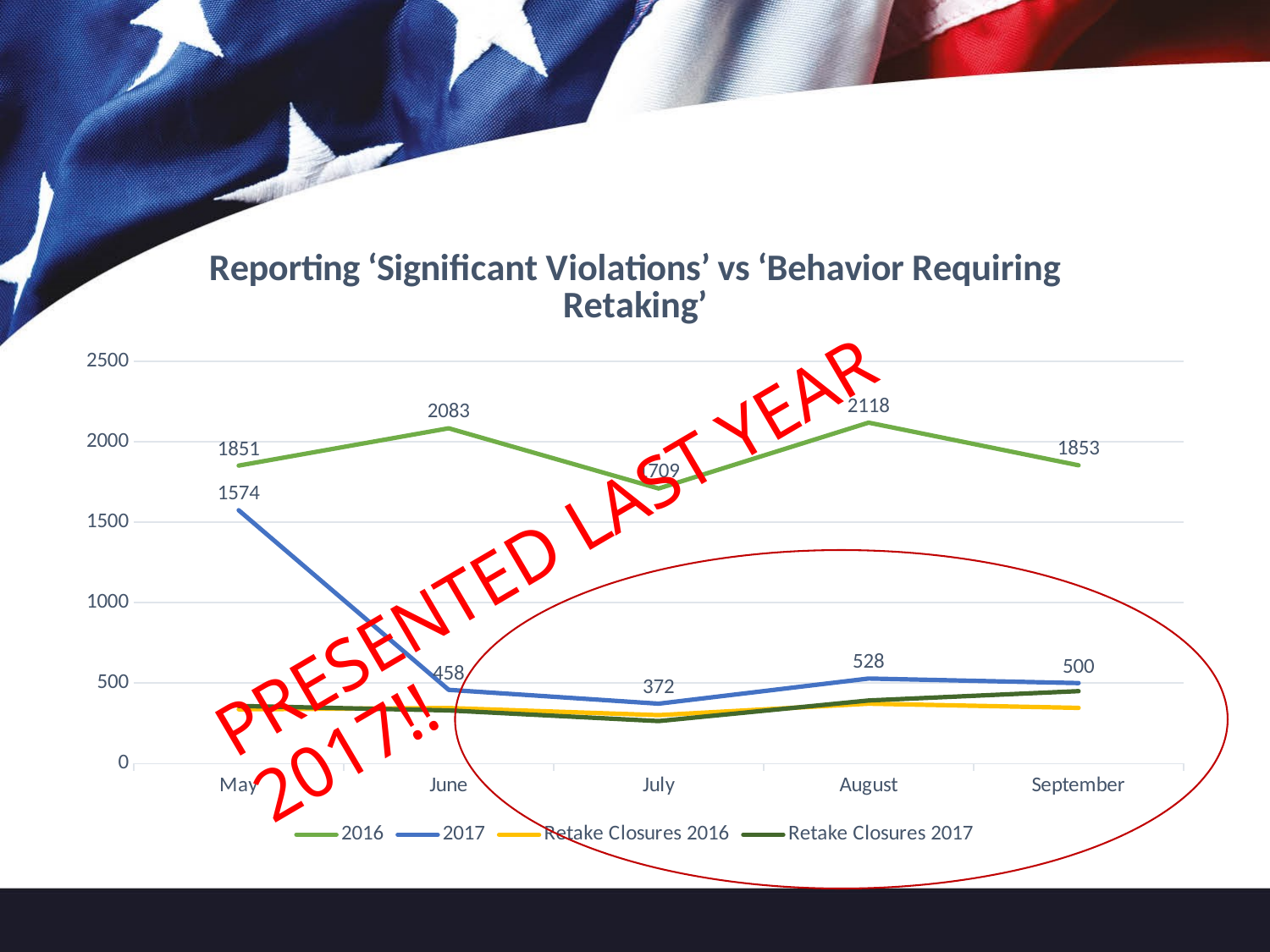
What is the difference between the 2017 values for May and June? 1116 How many months are shown on the x axis? 5 What is the value for the 2017 series in August? 528 What is the value for the 2016 series in September? 1853 Is the value for Retake Closures 2016 in August greater or less than 500? less What is the value for the 2017 series in May? 1574 How many series does the legend list? 4 Which is larger, the 2016 value in May or the 2016 value in September? 2016 value in September In which month is the 2016 series highest? August What is the value for the 2016 series in June? 2083 In which month is the 2017 series lowest? July What type of chart is shown on the slide? line chart